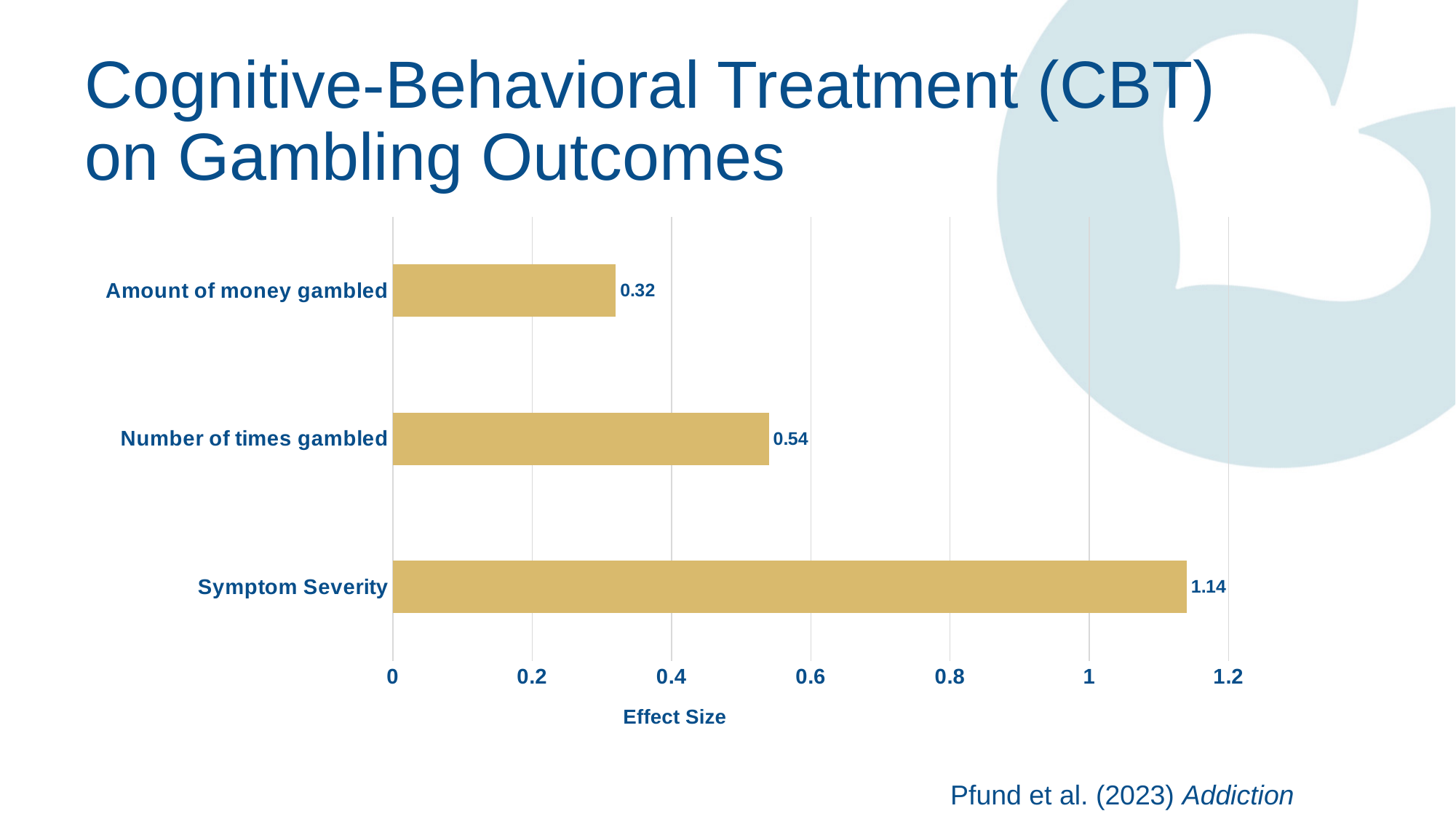
Which outcome has the smallest effect size? Amount of money gambled How many outcomes are shown in the chart? 3 What is the effect size for Amount of money gambled? 0.32 Which has a larger effect size, Number of times gambled or Amount of money gambled? Number of times gambled Is the effect size for Symptom Severity greater or less than 1? greater What is the effect size for Number of times gambled? 0.54 Which outcome has the largest effect size? Symptom Severity What is the effect size for Symptom Severity? 1.14 What kind of chart is shown on the slide? Bar chart What is the difference in effect size between Number of times gambled and Amount of money gambled? 0.22 What is the difference in effect size between Symptom Severity and Number of times gambled? 0.60 What is the label of the horizontal axis? Effect Size